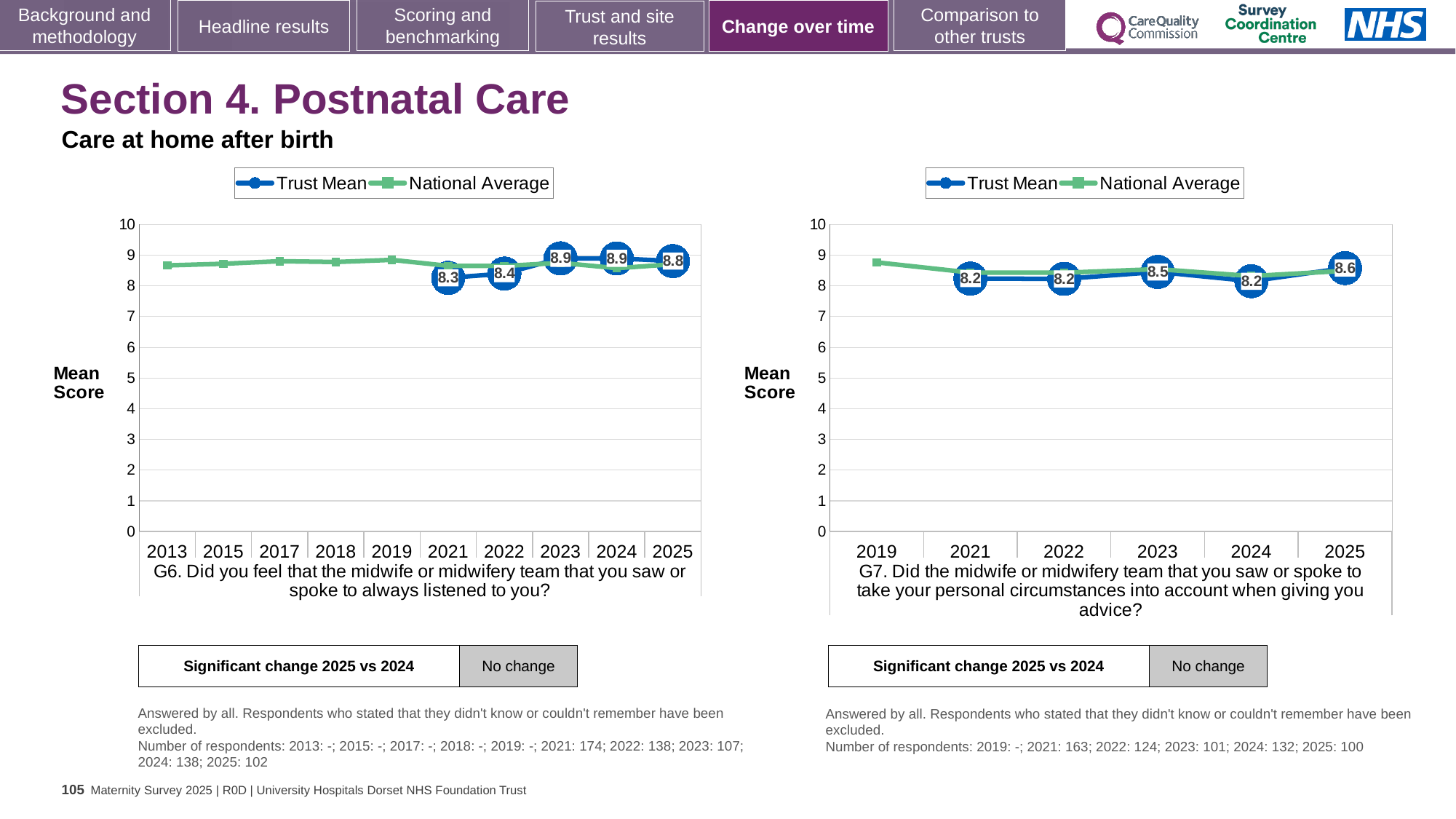
In the right chart (G7), is the Trust Mean score higher in 2023 or in 2024? 2023 In the left chart (G6), what is the Trust Mean score for 2025? 8.8 In the left chart (G6), what is the difference between the Trust Mean scores for 2023 and 2021? 0.6 In the left chart (G6), is the National Average value for 2013 greater or less than 8? greater How many years are shown on the x axis of the right chart (G7)? 6 In the right chart (G7), which year has the highest Trust Mean score? 2025 In the left chart (G6), which year has the lowest labelled Trust Mean score? 2021 In the left chart (G6), what is the Trust Mean score for 2021? 8.3 How many series does the legend of the left chart (G6) list? 2 In the right chart (G7), what is the difference between the Trust Mean scores for 2025 and 2024? 0.4 In the right chart (G7), what is the Trust Mean score for 2023? 8.5 What type of chart is used for the G6 question on the left? Line chart